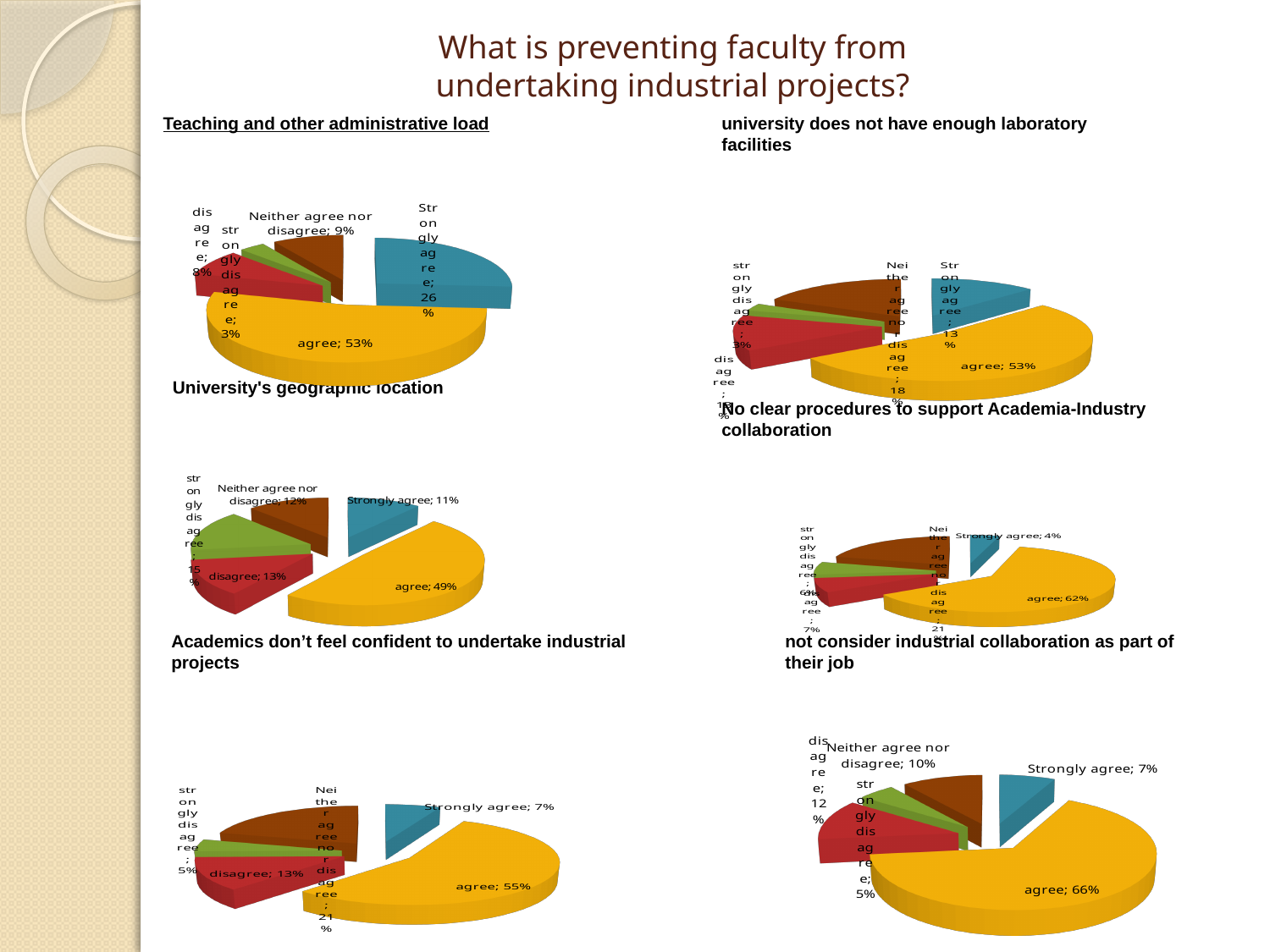
In the 'University's geographic location' chart, what is the difference between the 'agree' and 'Strongly agree' shares? 38% In the 'Teaching and other administrative load' chart, which response has the smallest share? strongly disagree In the 'university does not have enough laboratory facilities' chart, what percentage chose 'Strongly agree'? 13% How many pie charts are shown on the slide? 6 In the 'not consider industrial collaboration as part of their job' chart, what percentage chose 'agree'? 66% In the 'No clear procedures to support Academia-Industry collaboration' chart, what percentage chose 'agree'? 62% In the 'university does not have enough laboratory facilities' chart, which response has the largest share? agree In the 'No clear procedures to support Academia-Industry collaboration' chart, which is larger: 'Neither agree nor disagree' or 'Strongly agree'? Neither agree nor disagree In the 'University's geographic location' chart, what percentage chose 'strongly disagree'? 15% In the 'Teaching and other administrative load' chart, what percentage of respondents chose 'agree'? 53% In the 'Academics don't feel confident to undertake industrial projects' chart, what percentage chose 'disagree'? 13% In the 'Teaching and other administrative load' chart, what share of the pie is 'Strongly agree'? 26%